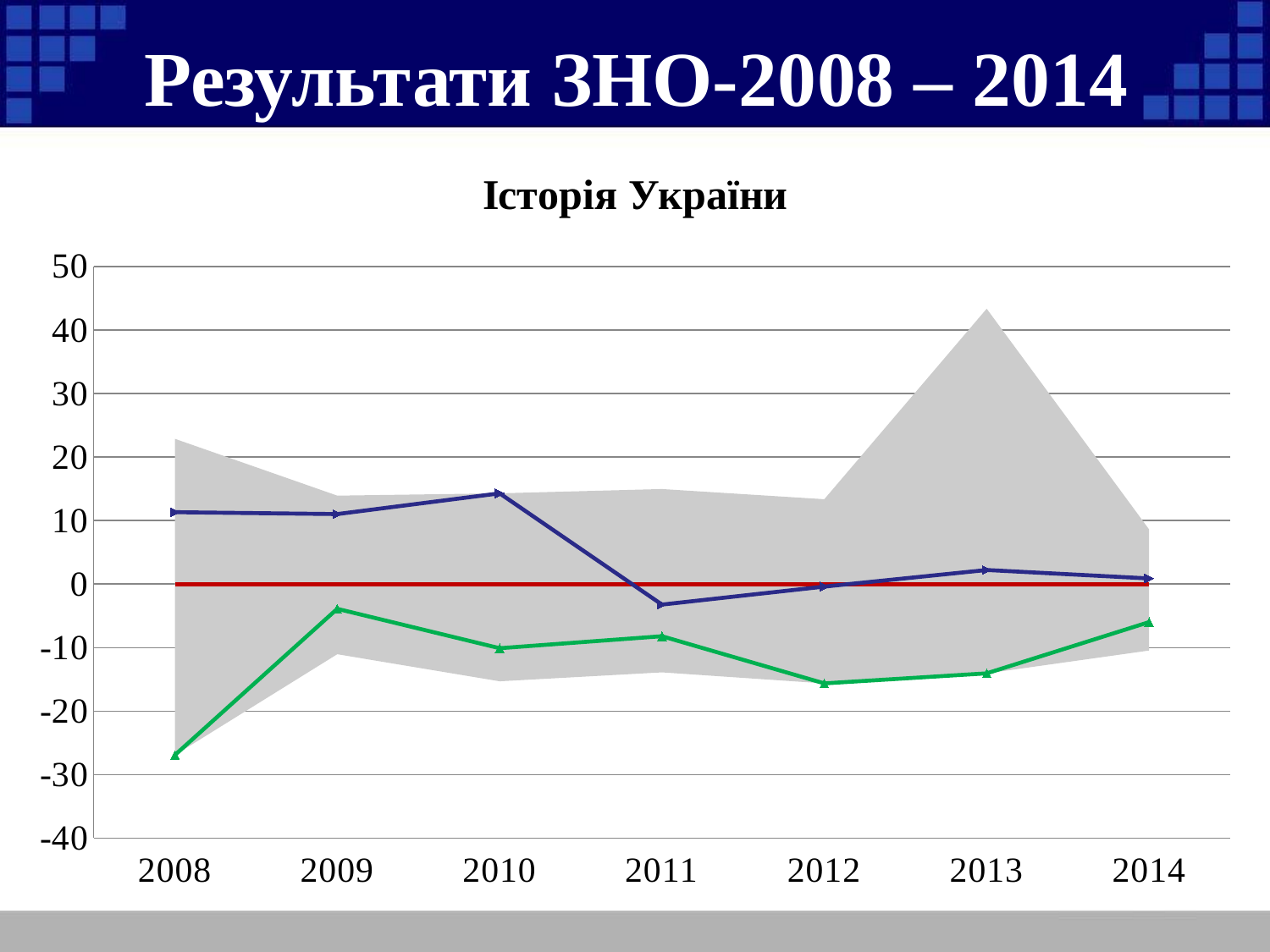
What kind of chart is shown on the slide? combination area and line chart Is the top of the grey shaded area for 2013 greater or less than 40? greater Is the value of the blue line for 2010 greater or less than 10? greater In which year is the blue line at its highest? 2010 In which year is the green line at its lowest? 2008 How many years are shown on the x axis of the chart? 7 In which year is the blue line at its lowest? 2011 For 2008, which line has the larger value, the blue line or the green line? blue line Is the value of the green line for 2008 greater or less than -20? less What is the title of the chart? Історія України Does the green line rise or fall from 2012 to 2014? rise